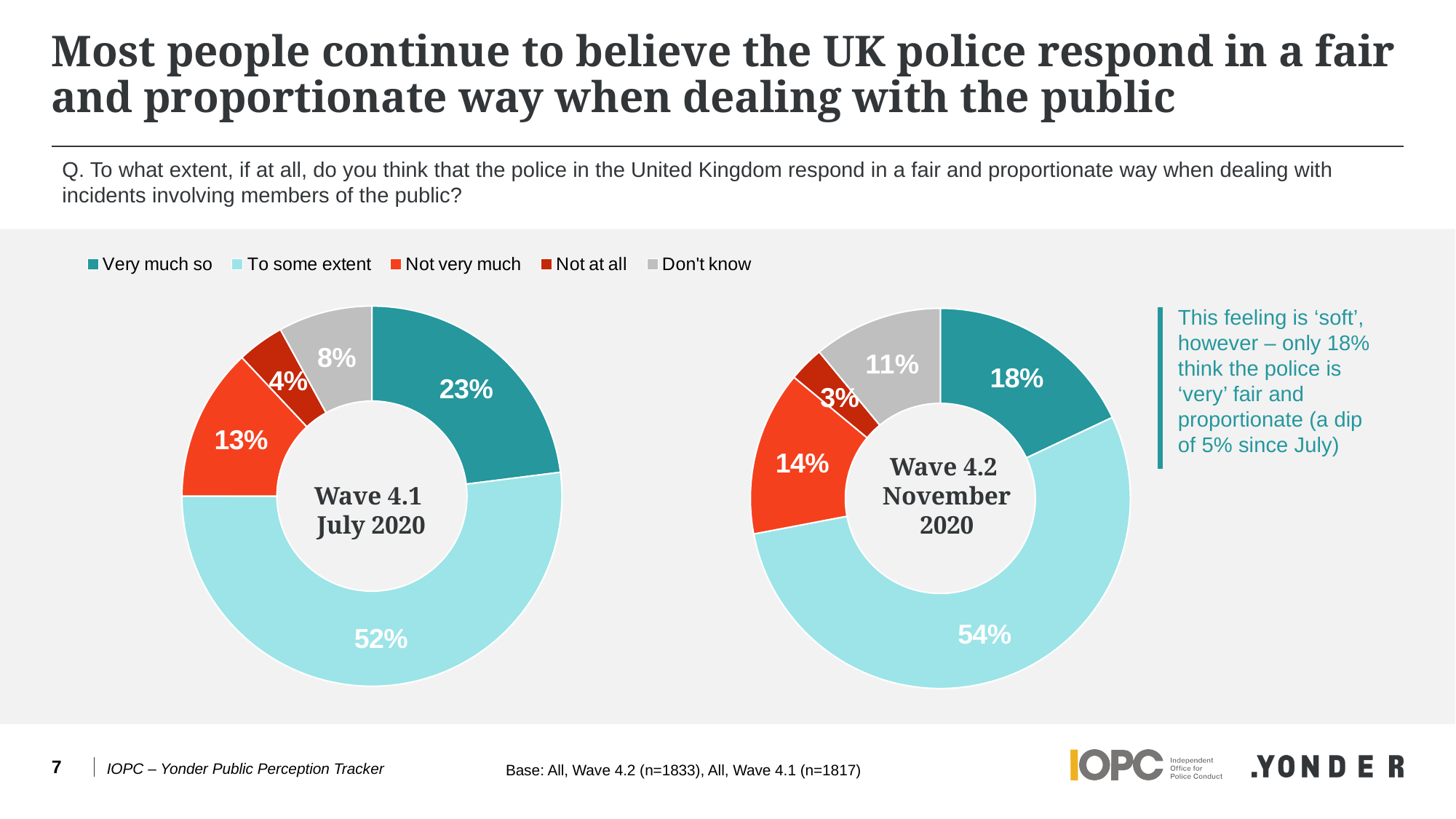
In the Wave 4.1 July 2020 chart, what percentage answered 'Very much so'? 23% What kind of chart is used on this slide? Pie chart (doughnut) Which colour represents 'Don't know' in the legend? Grey What is the difference between the 'Very much so' share in Wave 4.1 July 2020 and in Wave 4.2 November 2020? 5% How many series does the legend list? 5 In the Wave 4.2 November 2020 chart, what percentage answered 'To some extent'? 54% In the Wave 4.2 November 2020 chart, which response has the smallest share? Not at all Which is larger: the 'Not very much' share in Wave 4.1 July 2020 or in Wave 4.2 November 2020? Wave 4.2 November 2020 In the Wave 4.1 July 2020 chart, which response has the largest share? To some extent In the Wave 4.2 November 2020 chart, what is the combined share of 'Very much so' and 'To some extent'? 72% In the Wave 4.1 July 2020 chart, what percentage answered 'Not at all'? 4% In the Wave 4.2 November 2020 chart, what percentage answered 'Don't know'? 11%